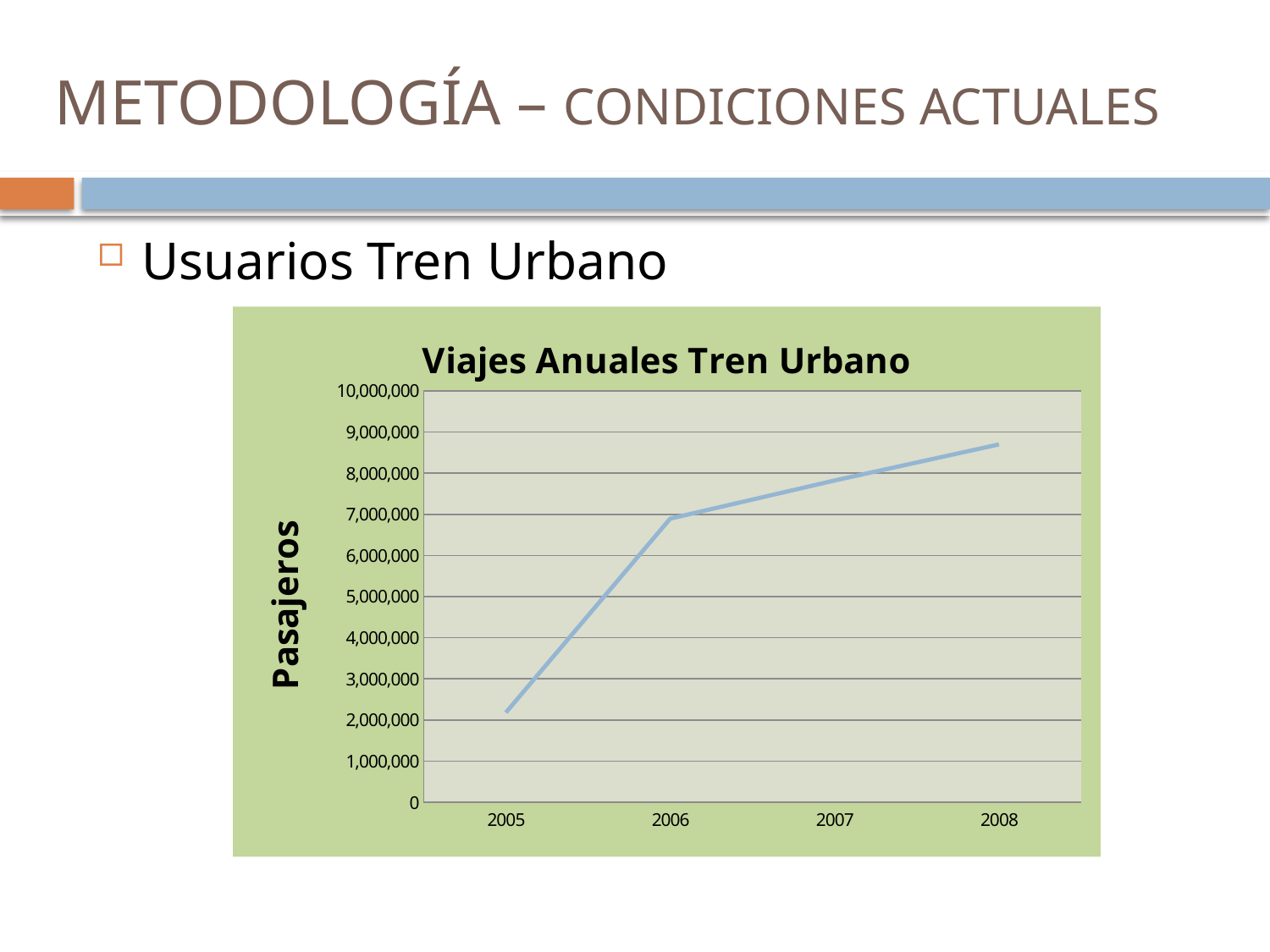
Is the value for 2006 greater or less than 6,000,000? greater Do the values in the chart rise or fall from 2005 to 2008? Rise Is the value for 2008 greater or less than 9,000,000? less Is the value for 2005 greater or less than 3,000,000? less What is the label on the vertical axis of the chart? Pasajeros Which year has the highest number of passengers in the chart? 2008 What is the title of the chart? Viajes Anuales Tren Urbano How many years are plotted on the x axis of the chart? 4 What kind of chart is shown on the slide? Line chart Which year has more passengers, 2005 or 2006? 2006 Which year has the lowest number of passengers in the chart? 2005